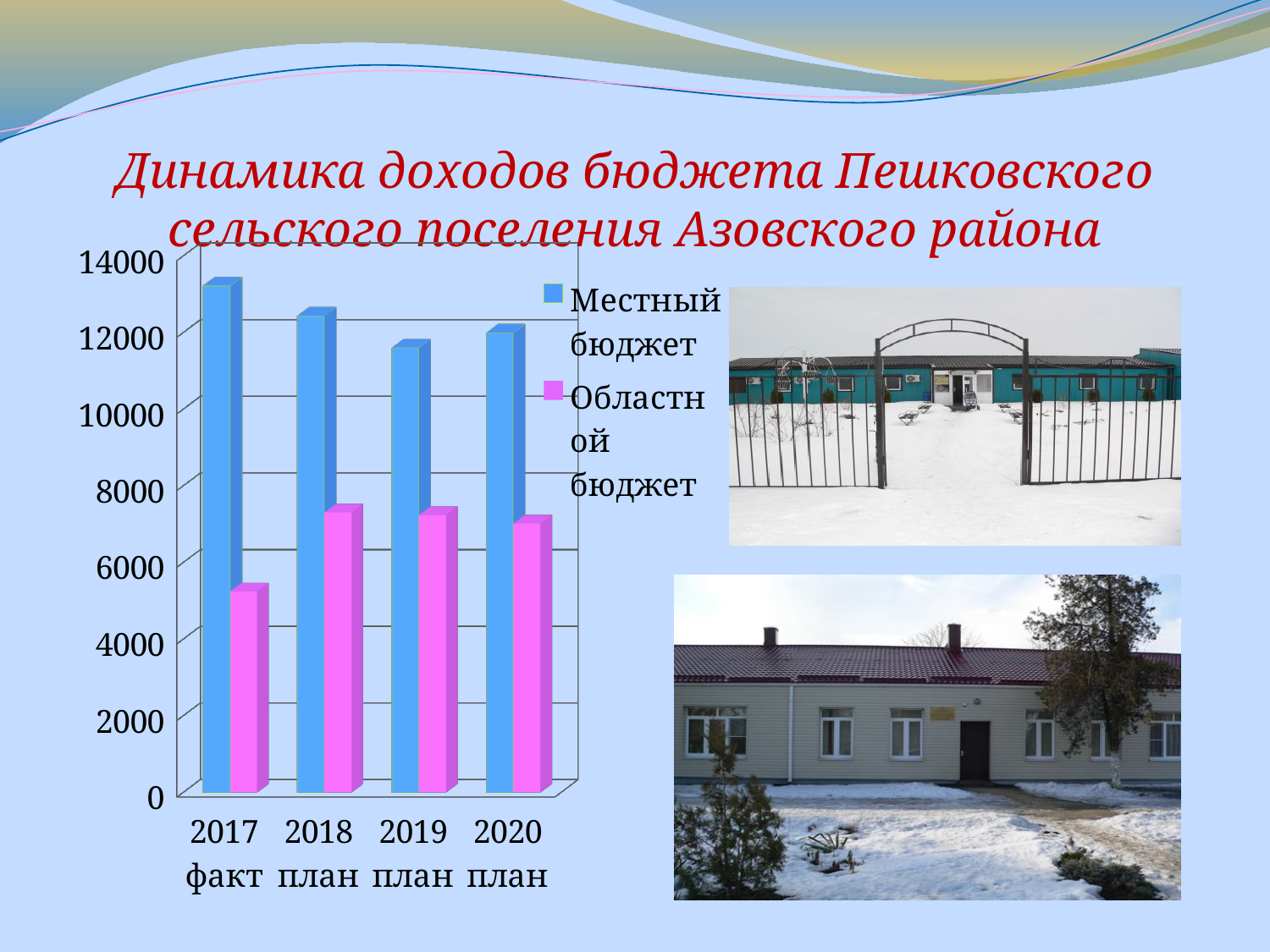
What kind of chart is shown on the slide? bar chart Which colour represents Областной бюджет in the chart? pink Is the value for Областной бюджет in 2018 greater or less than 6000? greater Does the value for Местный бюджет rise or fall from 2017 to 2019? fall Which year has the highest value for Местный бюджет? 2017 факт How many year categories are shown on the x axis of the chart? 4 Is the value for Областной бюджет in 2017 greater or less than 6000? less In 2017, which is larger: Местный бюджет or Областной бюджет? Местный бюджет Is the value for Местный бюджет in 2019 greater or less than 12000? less How many series does the chart legend list? 2 Which year has the lowest value for Областной бюджет? 2017 факт